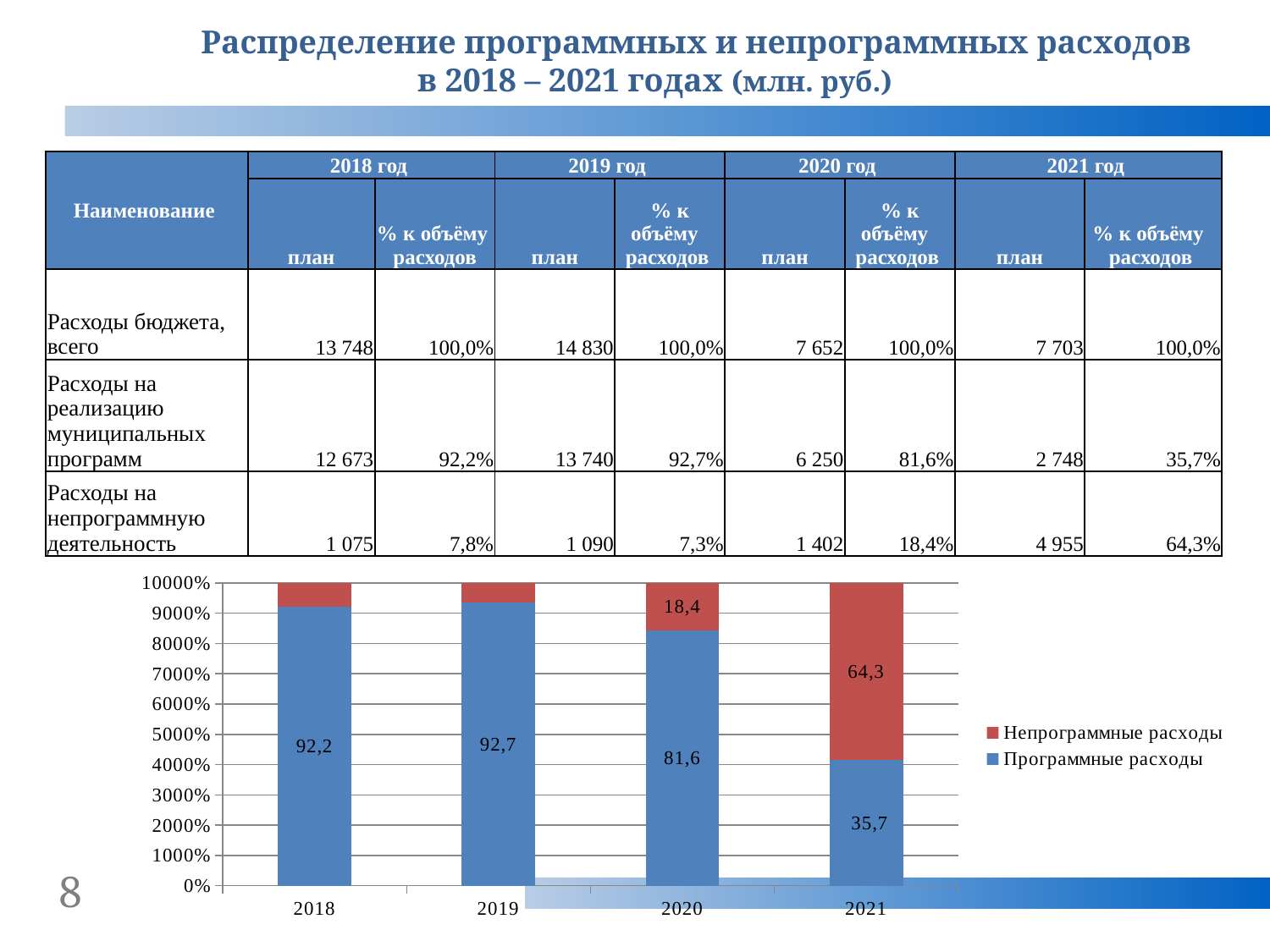
What is the value of Непрограммные расходы for 2021 in the chart? 64,3 How many years are shown on the x axis of the chart? 4 What is the value of Программные расходы for 2021 in the chart? 35,7 What is the value of Непрограммные расходы for 2020 in the chart? 18,4 What is the value of Программные расходы for 2020 in the chart? 81,6 What kind of chart is shown on the slide? Stacked bar chart In which year is the Программные расходы value lowest in the chart? 2021 What is the value of Программные расходы for 2018 in the chart? 92,2 How many series does the chart legend list? 2 Which series is shown in red in the chart? Непрограммные расходы What is the value of Программные расходы for 2019 in the chart? 92,7 What is the difference between the Непрограммные расходы values for 2021 and 2020 in the chart? 45,9